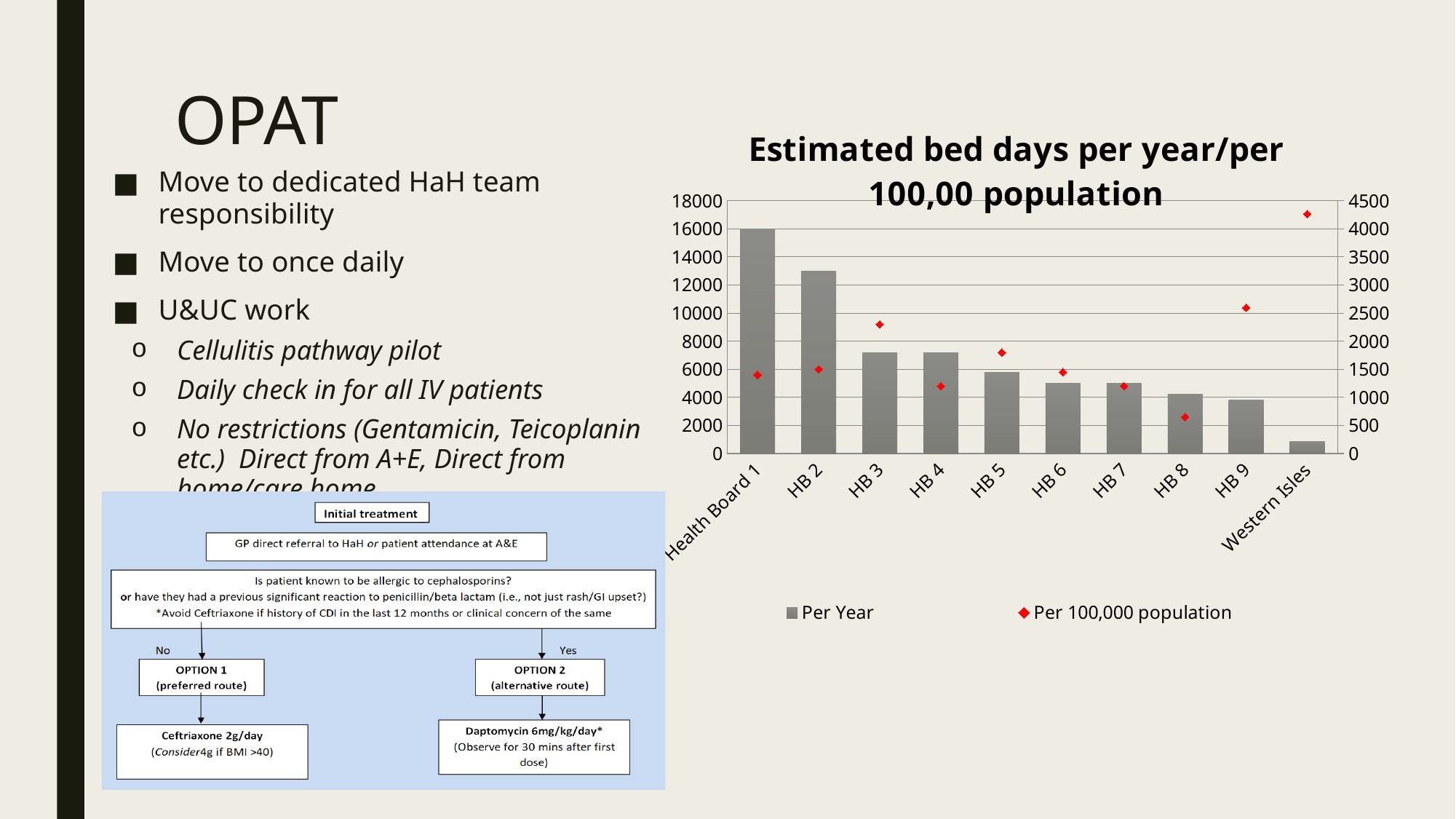
How many health boards (categories) are shown on the x axis of the chart? 10 Is the Per 100,000 population value for Western Isles greater or less than 4000? greater Which category has the lowest Per 100,000 population value? HB 8 Which category has the highest Per Year bar? Health Board 1 What kind of chart is shown on the slide? bar chart with a line/marker series (combination chart) Which has the larger Per Year bar, HB 5 or HB 8? HB 5 Is the Per Year value for Western Isles greater or less than 2000? less How many series does the chart legend list? 2 Is the Per Year value for HB 2 greater or less than 12000? greater Do the Per Year bars generally rise or fall from left to right across the x axis? fall Which category has the lowest Per Year bar? Western Isles Which category has the highest Per 100,000 population value? Western Isles